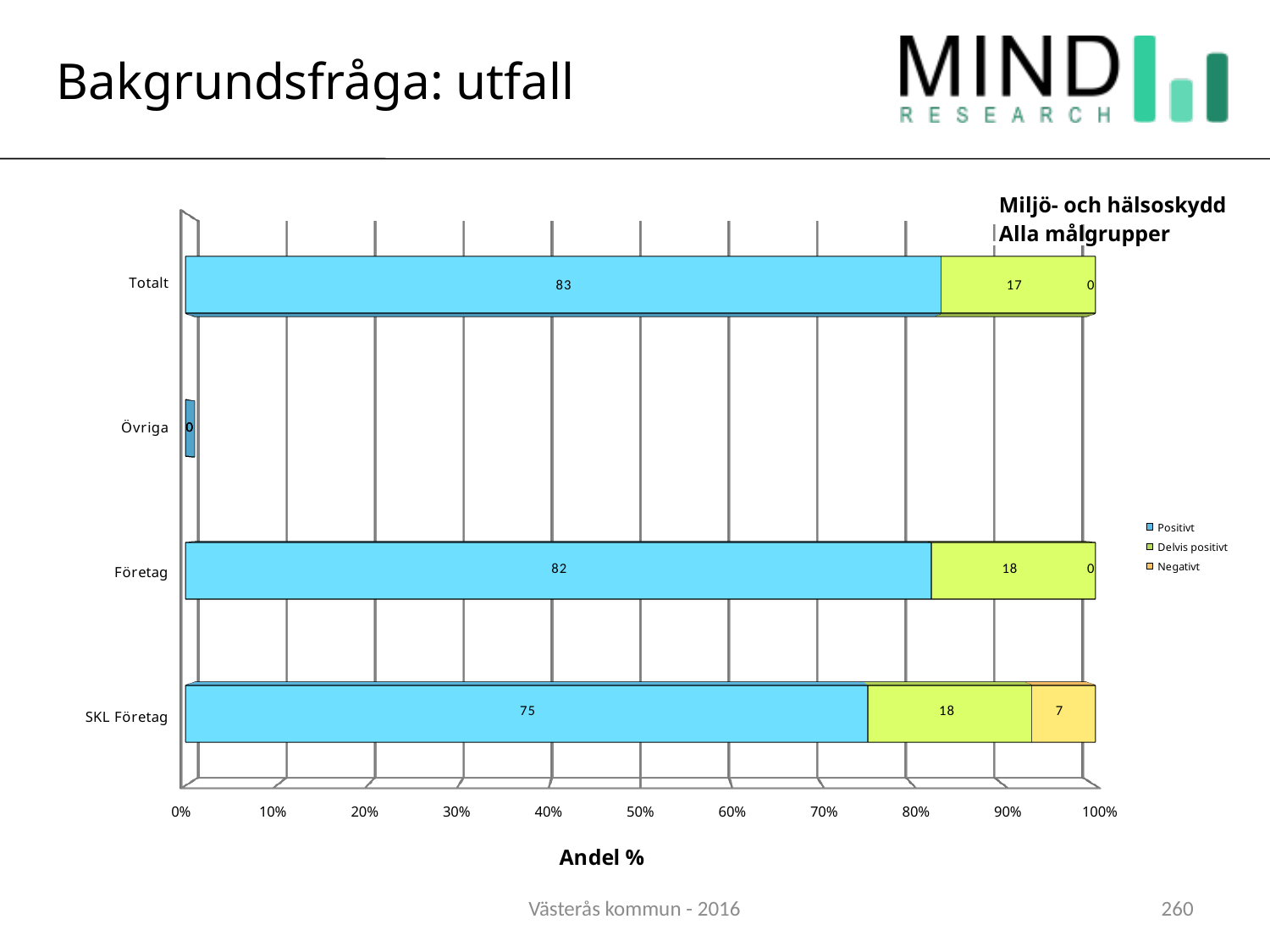
What is the label on the horizontal axis of the chart? Andel % How many series does the legend list? 3 Which is larger, the Positivt value for Företag or for SKL Företag? Företag Which category has the highest Positivt value? Totalt What is the Positivt value for SKL Företag? 75 What is the difference between the Positivt values for Totalt and SKL Företag? 8 What is the total of the stacked bar for SKL Företag? 100 What is the Positivt value for Totalt? 83 How many categories are shown on the vertical axis of the chart? 4 What kind of chart is shown on the slide? bar chart What is the Negativt value for SKL Företag? 7 What is the Delvis positivt value for Företag? 18